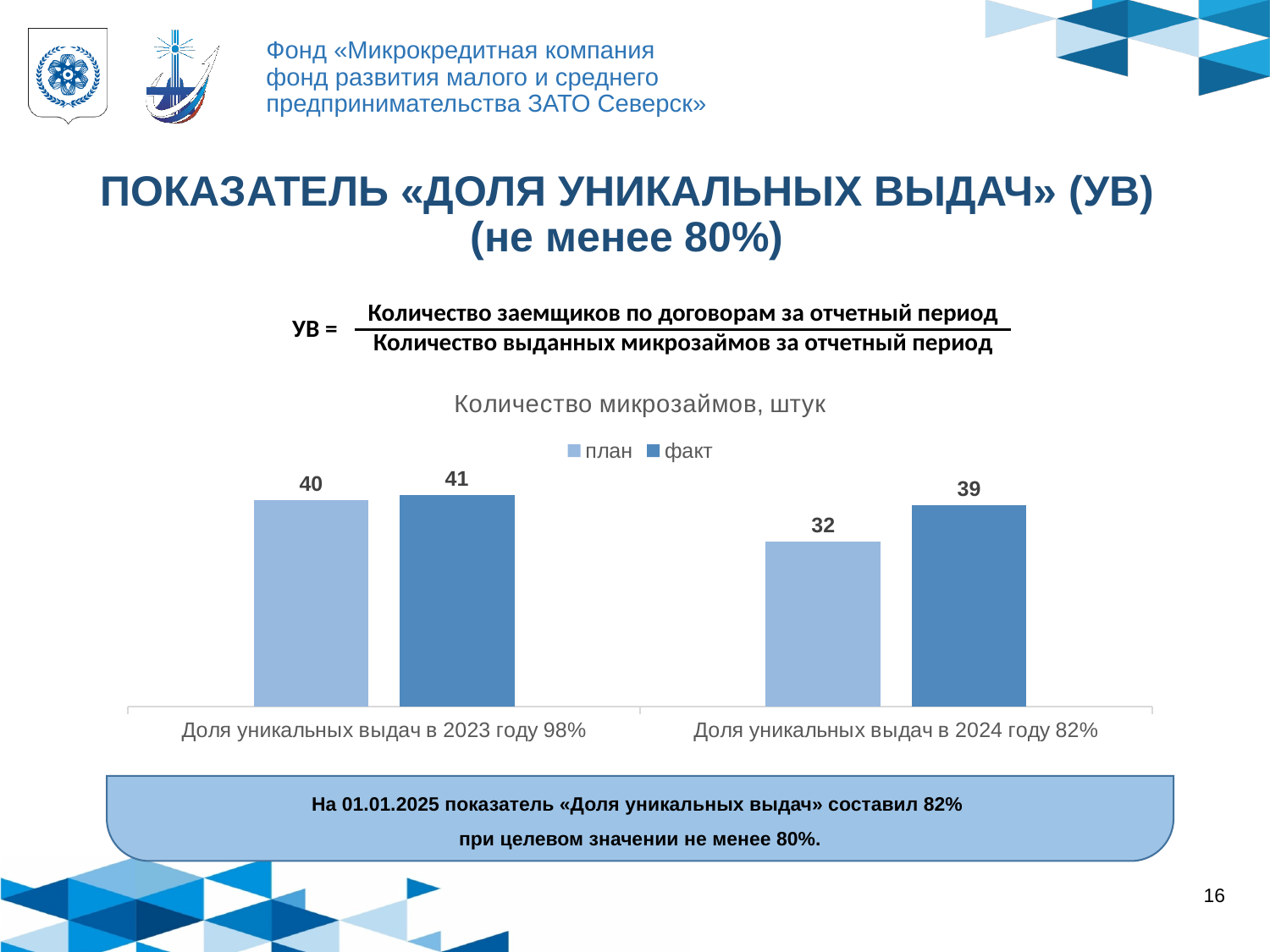
What are the series names in the legend? план, факт What is the 'факт' value for 'Доля уникальных выдач в 2023 году 98%'? 41 What type of chart is shown on the slide? bar chart What is the 'план' value for 'Доля уникальных выдач в 2024 году 82%'? 32 What is the 'факт' value for 'Доля уникальных выдач в 2024 году 82%'? 39 What is the title of the chart? Количество микрозаймов, штук How many categories are shown on the x axis? 2 Which category has the lowest 'план' value? Доля уникальных выдач в 2024 году 82% What is the difference between the 'факт' and 'план' values for 'Доля уникальных выдач в 2024 году 82%'? 7 Which is larger for 'Доля уникальных выдач в 2023 году 98%': the 'план' value or the 'факт' value? факт How many series does the legend list? 2 What is the 'план' value for 'Доля уникальных выдач в 2023 году 98%'? 40